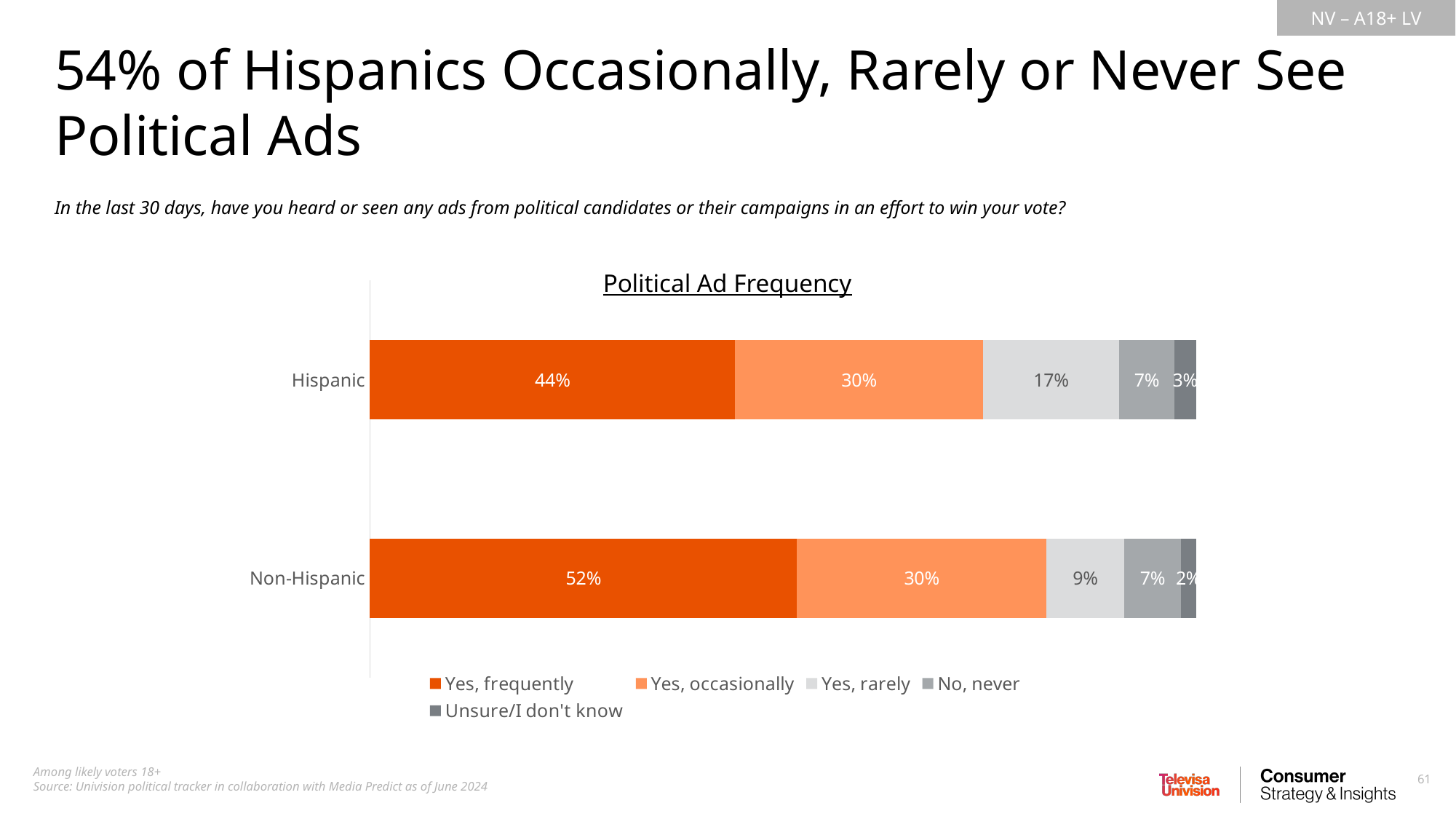
How many groups are compared in the chart? 2 Which group has the higher 'Yes, frequently' value, Hispanic or Non-Hispanic? Non-Hispanic What is the 'Yes, rarely' value for Hispanic respondents? 17% How many series does the legend list? 5 What percentage of Hispanics say they see political ads frequently? 44% What is the difference between the 'Yes, rarely' values for Hispanic and Non-Hispanic respondents? 8 percentage points What is the combined share of Hispanics who answered 'Yes, occasionally', 'Yes, rarely' or 'No, never'? 54% What is the 'Unsure/I don't know' value for Hispanic respondents? 3% What is the difference between the 'Yes, frequently' values for Non-Hispanic and Hispanic respondents? 8 percentage points What is the 'Yes, rarely' value for Non-Hispanic respondents? 9% What type of chart is shown on the slide? Stacked bar chart What percentage of Non-Hispanics say they see political ads frequently? 52%